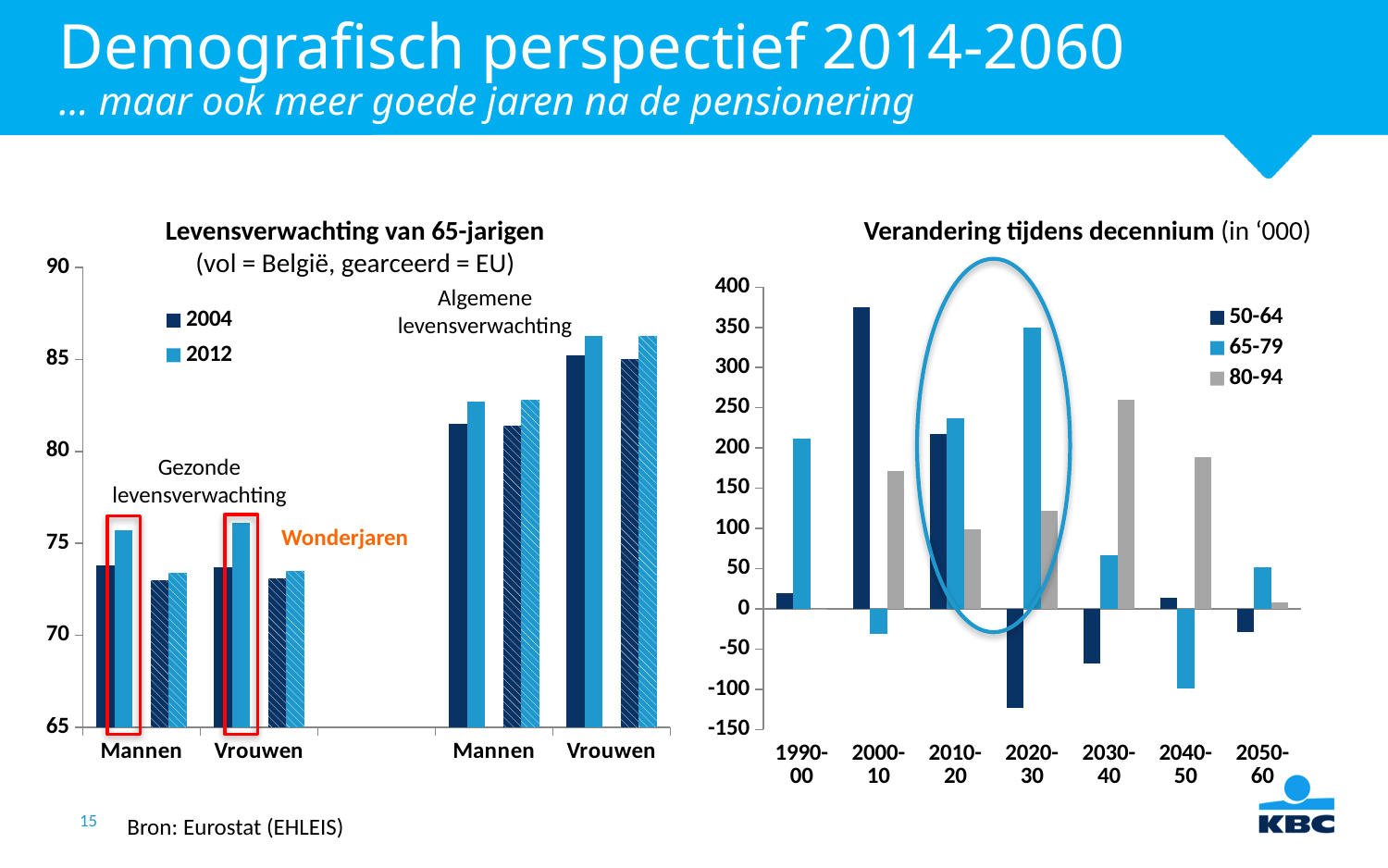
In the 'Verandering tijdens decennium' chart, is the value for 50-64 in 2000-10 greater or less than 350? greater In the 'Verandering tijdens decennium' chart, in which decade is the 80-94 series highest? 2030-40 In the 'Verandering tijdens decennium' chart, in which decade is the 50-64 series highest? 2000-10 In the 'Levensverwachting van 65-jarigen' chart, is the solid 2012 bar for Vrouwen under 'Algemene levensverwachting' greater or less than 85? greater How many decade categories are shown on the x axis of the 'Verandering tijdens decennium' chart? 7 In the 'Verandering tijdens decennium' chart, in which decade is the 65-79 series highest? 2020-30 In the 'Verandering tijdens decennium' chart, is the value for 65-79 in 2040-50 greater or less than -50? less What kind of chart is the chart titled 'Verandering tijdens decennium'? bar chart In the 'Verandering tijdens decennium' chart, which is larger in 2010-20: the 65-79 value or the 80-94 value? 65-79 In the 'Verandering tijdens decennium' chart, in which decade is the 50-64 series lowest? 2020-30 How many series does the legend of the 'Verandering tijdens decennium' chart list? 3 How many series does the legend of the 'Levensverwachting van 65-jarigen' chart list? 2